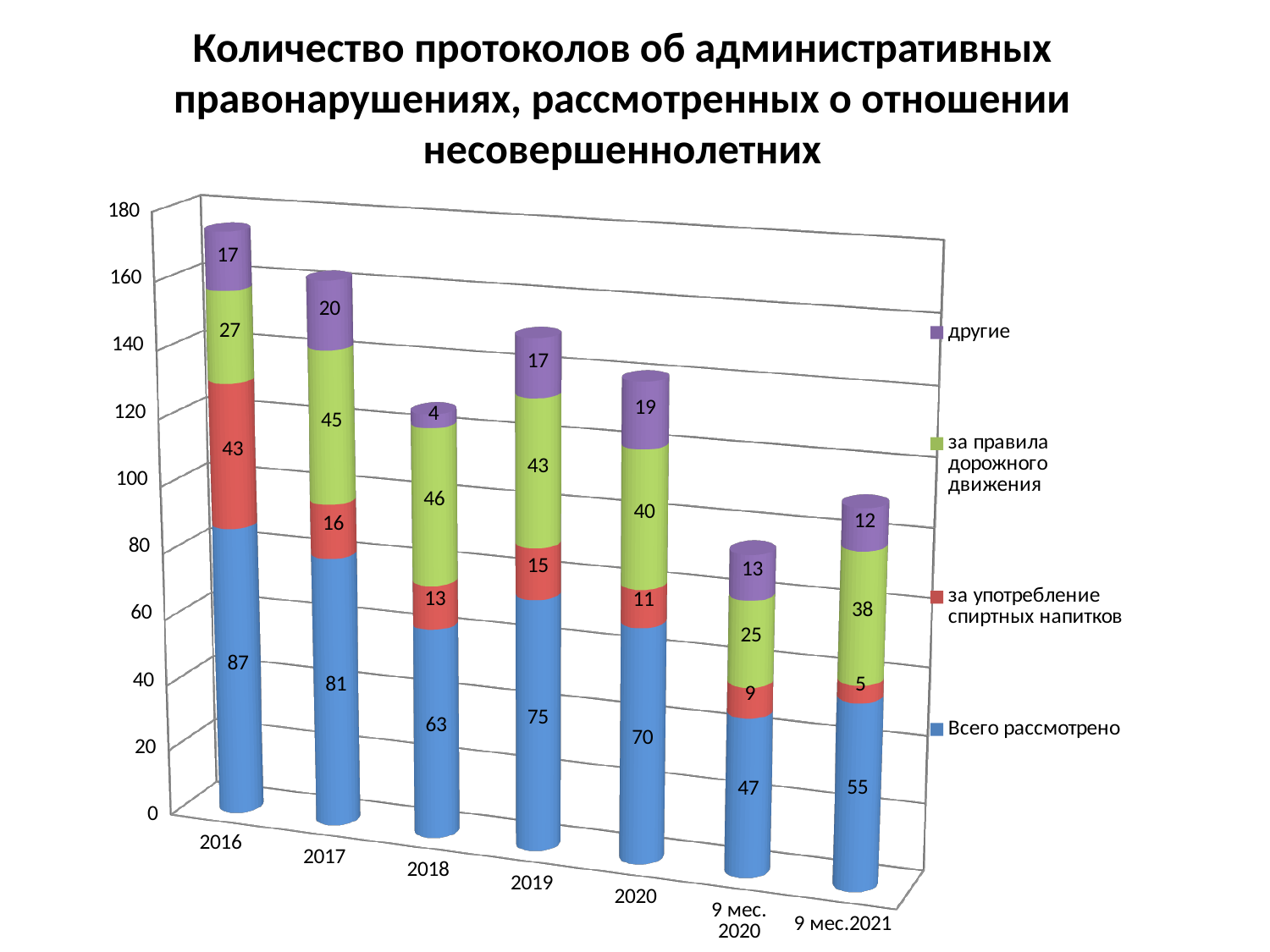
Which is larger: "за употребление спиртных напитков" in 2016 or in 2017? 2016 What kind of chart is shown on the slide? Stacked bar chart What is the difference between the "Всего рассмотрено" values for 2016 and 2017? 6 Which category has the highest value for "Всего рассмотрено"? 2016 What is the value of "другие" for 2020? 19 Which category has the lowest value for "другие"? 2018 How many series does the legend list? 4 What is the value of "за употребление спиртных напитков" for 9 мес.2021? 5 What is the value of "Всего рассмотрено" for 2016? 87 What is the value of "за правила дорожного движения" for 2018? 46 What is the total of the stacked bar for 9 мес. 2020? 94 How many categories are shown on the x axis? 7